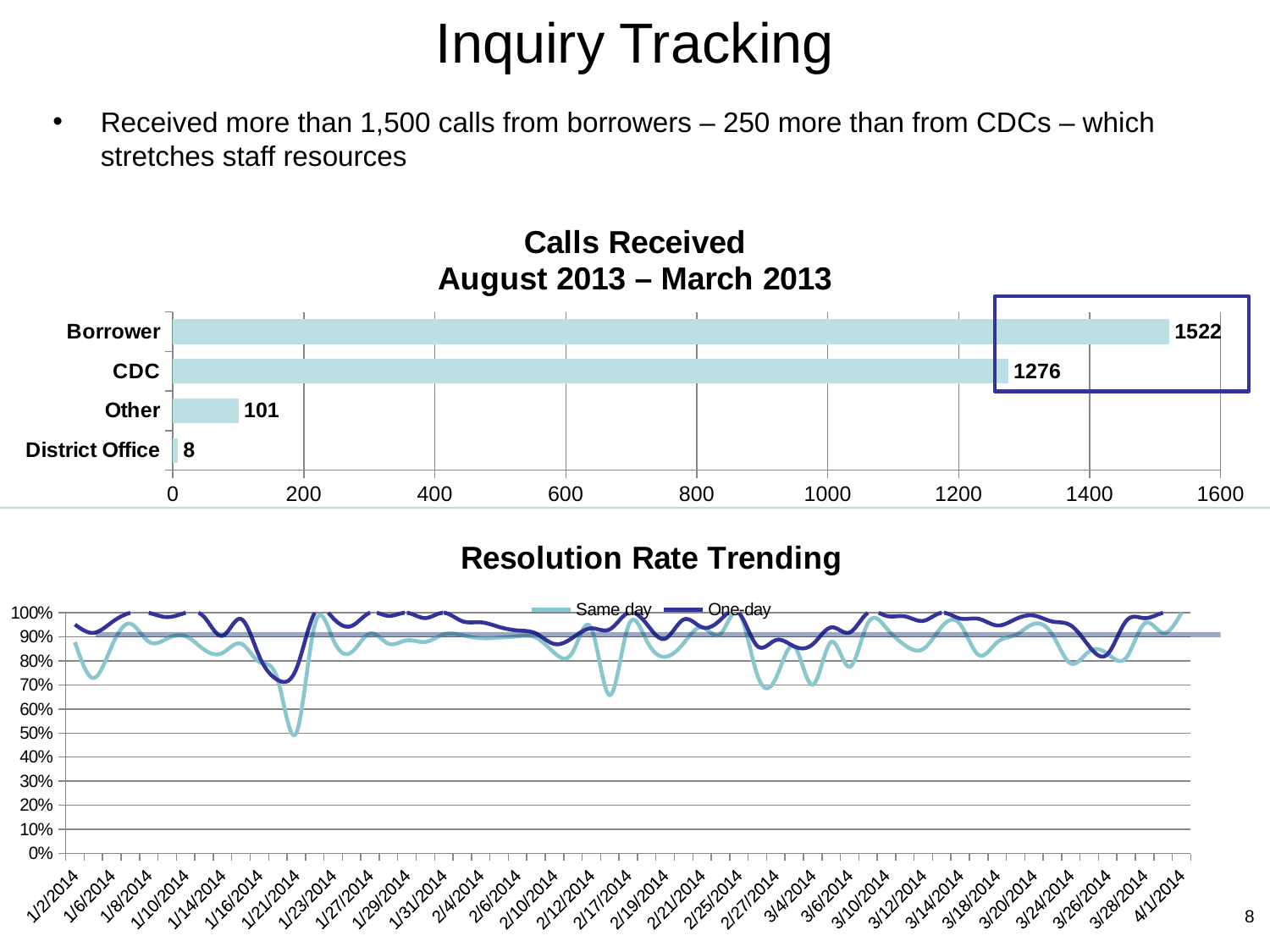
In the Resolution Rate Trending chart, is the Same day value on 1/21/2014 greater or less than 60%? less How many series does the legend of the Resolution Rate Trending chart list? 2 In the Calls Received chart, which is larger, Other or District Office? Other In the Calls Received chart, how many calls were received from Borrowers? 1522 How many categories are shown in the Calls Received chart? 4 In the Calls Received chart, how many calls were received from CDCs? 1276 In the Calls Received chart, which category has the lowest number of calls? District Office In the Calls Received chart, which category has the highest number of calls? Borrower In the Calls Received chart, what is the value for District Office? 8 What type of chart is the Calls Received chart? Bar chart In the Calls Received chart, what is the value for Other? 101 In the Calls Received chart, what is the difference between the Borrower and CDC values? 246